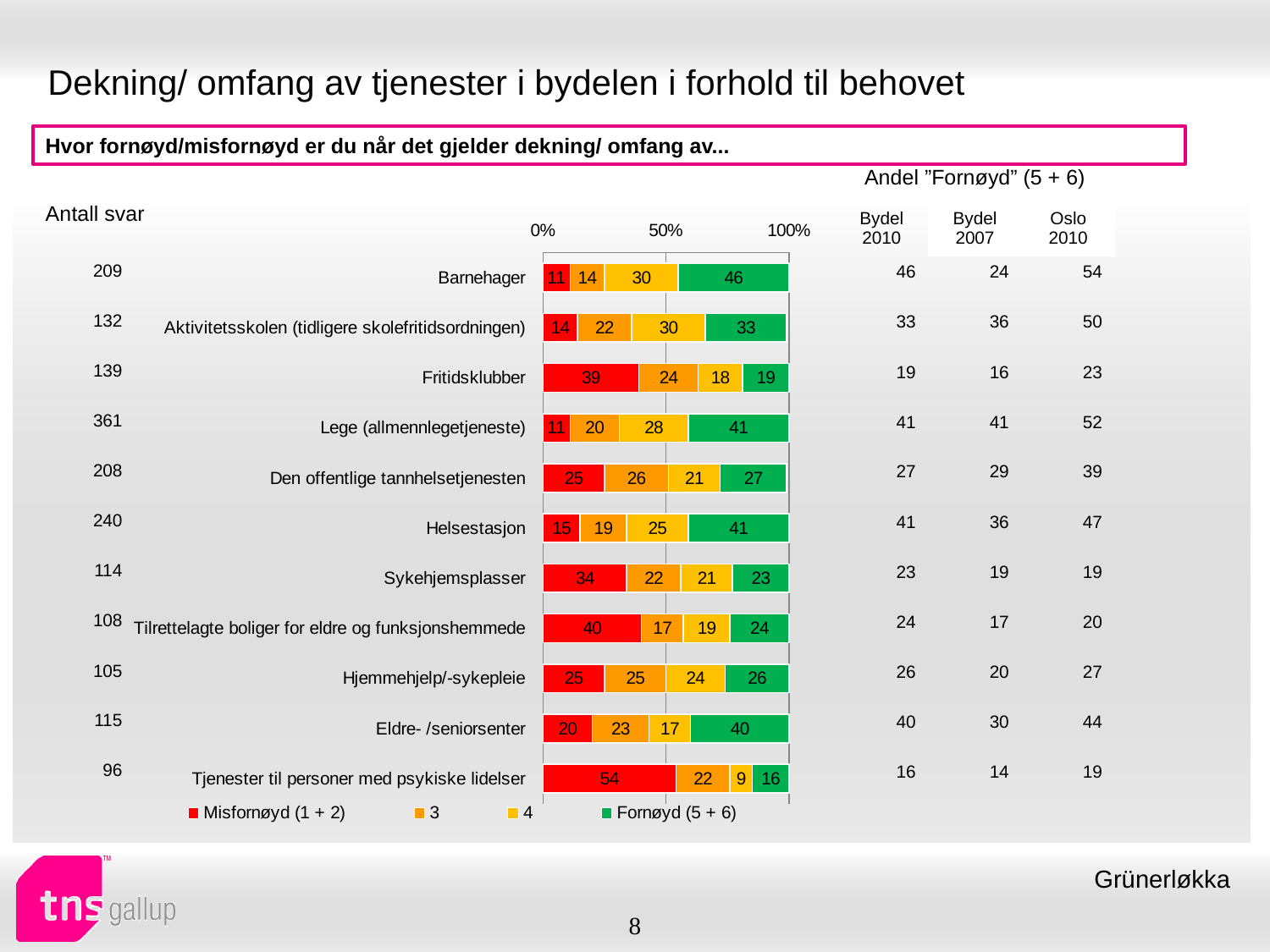
Which category has the highest Misfornøyd (1 + 2) value? Tjenester til personer med psykiske lidelser What is the value of the Fornøyd (5 + 6) segment for Barnehager? 46 What is the value of the '3' segment for Hjemmehjelp/-sykepleie? 25 What is the difference between the Fornøyd (5 + 6) values for Barnehager and Fritidsklubber? 27 How many series does the legend list? 4 What colour represents Fornøyd (5 + 6) in the chart? Green How many categories are shown in the bar chart? 11 Which category has the lowest Fornøyd (5 + 6) value? Tjenester til personer med psykiske lidelser What is the value of the Misfornøyd (1 + 2) segment for Tjenester til personer med psykiske lidelser? 54 What kind of chart is shown on the slide? Stacked bar chart Which category has the highest Fornøyd (5 + 6) value? Barnehager Which has a larger Misfornøyd (1 + 2) value, Fritidsklubber or Sykehjemsplasser? Fritidsklubber